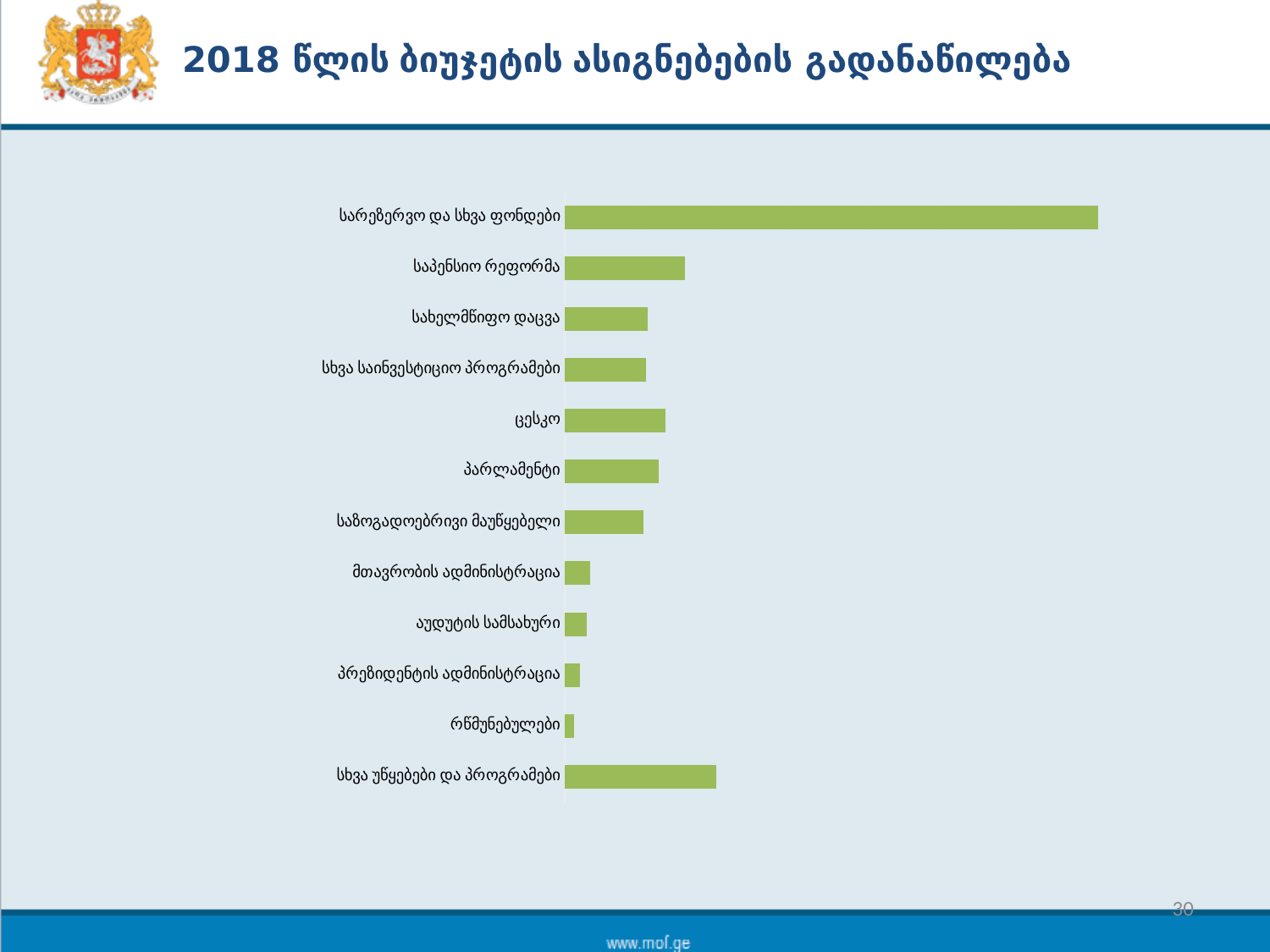
Which category has the shortest bar in the chart? რწმუნებულები What kind of chart is shown on the slide? bar chart Which bar is longer: პრეზიდენტის ადმინისტრაცია or რწმუნებულები? პრეზიდენტის ადმინისტრაცია Which bar is longer: ცესკო or მთავრობის ადმინისტრაცია? ცესკო Which bar is longer: სარეზერვო და სხვა ფონდები or საპენსიო რეფორმა? სარეზერვო და სხვა ფონდები What colour are the bars in the chart? green What is the title of the slide containing the chart? 2018 წლის ბიუჯეტის ასიგნებების გადანაწილება How many categories are plotted in the bar chart? 12 Which category has the longest bar in the chart? სარეზერვო და სხვა ფონდები